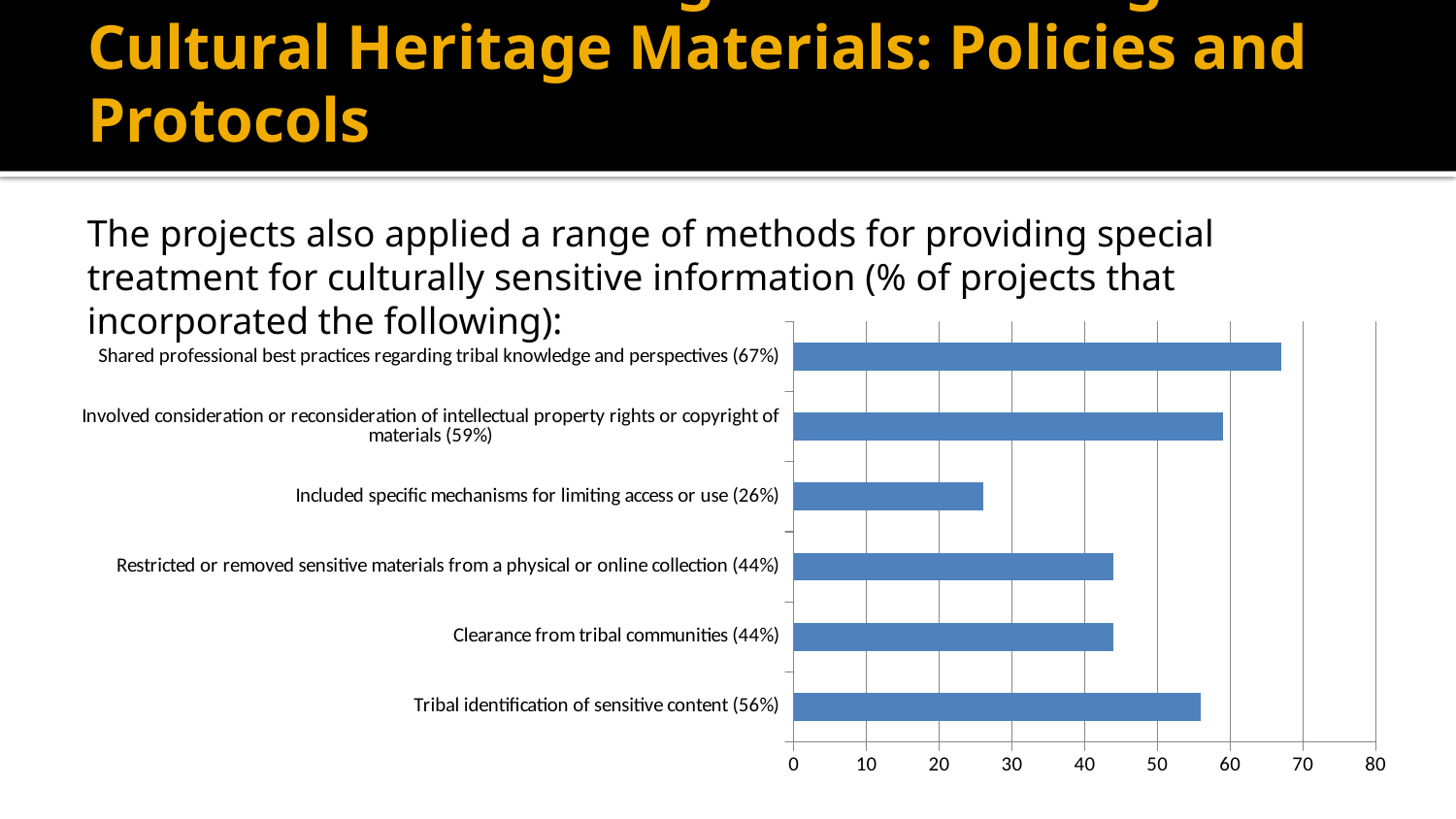
What percentage of projects involved tribal identification of sensitive content? 56% What is the maximum value shown on the horizontal axis? 80 Which category has the highest value? Shared professional best practices regarding tribal knowledge and perspectives Is the value for restricted or removed sensitive materials from a physical or online collection greater or less than 50? less Which category has the lowest value? Included specific mechanisms for limiting access or use How many categories does the chart show? 6 What percentage of projects shared professional best practices regarding tribal knowledge and perspectives? 67% Which is larger: the value for tribal identification of sensitive content or the value for clearance from tribal communities? Tribal identification of sensitive content What kind of chart is shown on the slide? bar chart What percentage of projects included specific mechanisms for limiting access or use? 26% What is the difference between the value for shared professional best practices (67%) and the value for included specific mechanisms for limiting access or use (26%)? 41% Is the value for involved consideration or reconsideration of intellectual property rights or copyright of materials greater or less than 50? greater